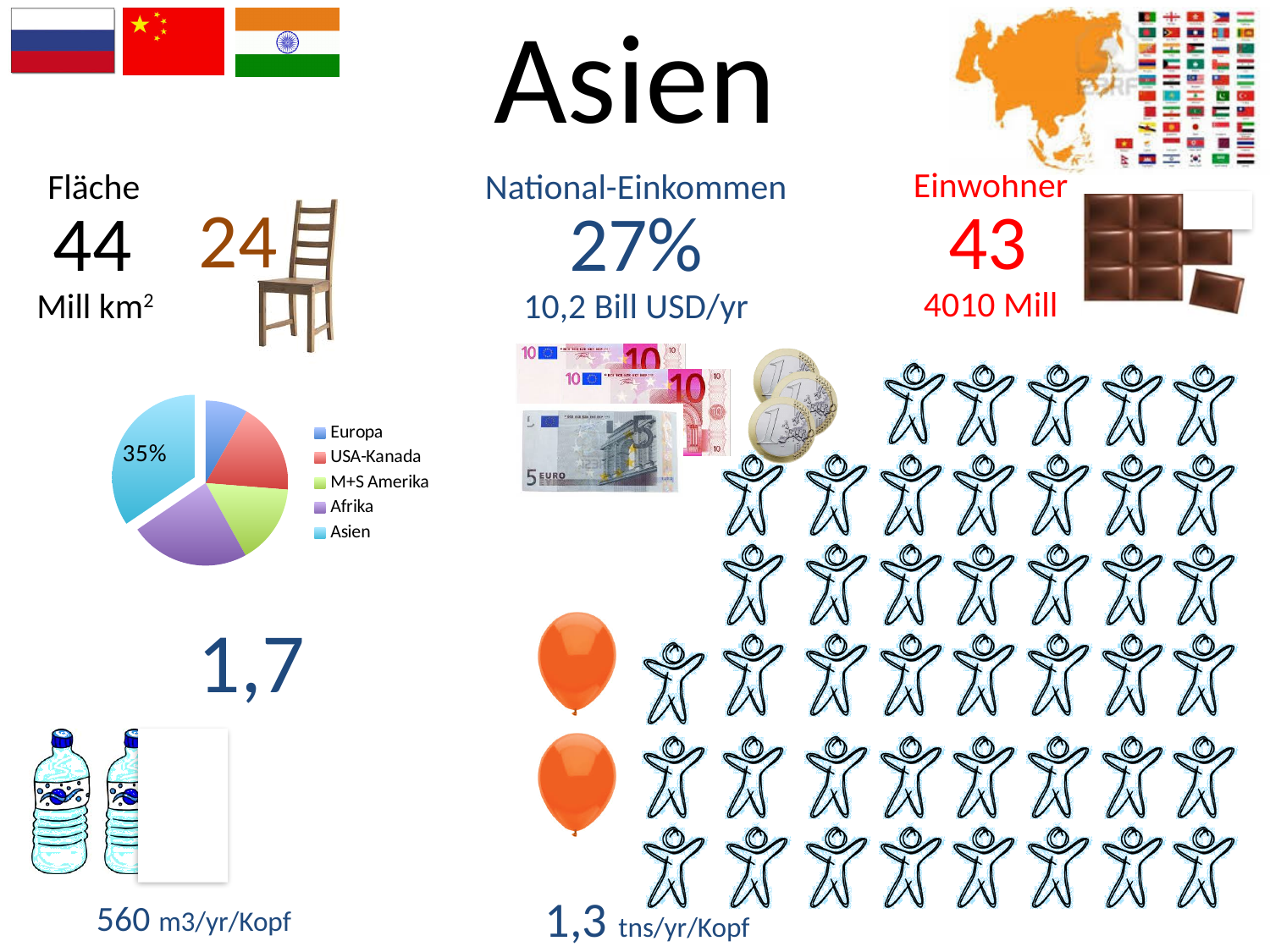
What share of the pie chart does Asien have? 35% Which slice is larger in the pie chart, Afrika or USA-Kanada? Afrika What colour is the Asien slice in the pie chart? light blue Which category has the largest slice in the pie chart? Asien Which slice is larger in the pie chart, Asien or Europa? Asien How many categories does the pie chart's legend list? 5 What is the only data label printed on the pie chart? 35% Which legend entry is listed first in the pie chart's legend? Europa Which slice is larger in the pie chart, Afrika or Europa? Afrika What kind of chart is shown on the slide? pie chart